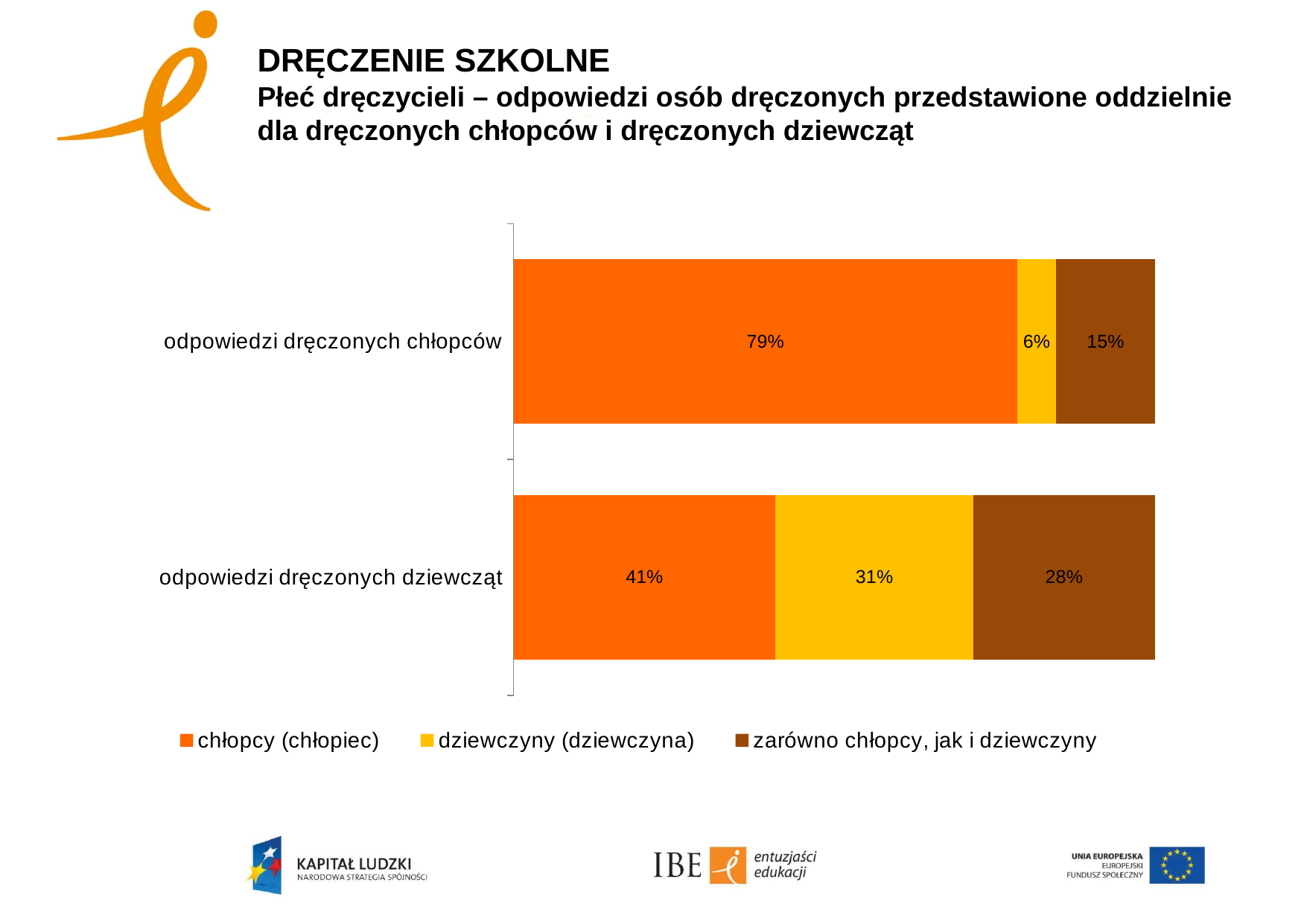
What kind of chart is shown on the slide? Stacked horizontal bar chart What is the value for 'chłopcy (chłopiec)' in the bar for odpowiedzi dręczonych dziewcząt? 41% What is the difference between the 'zarówno chłopcy, jak i dziewczyny' values for odpowiedzi dręczonych dziewcząt and odpowiedzi dręczonych chłopców? 13 percentage points Which series has the largest value in the bar for odpowiedzi dręczonych dziewcząt? chłopcy (chłopiec) What percentage of bullied girls (odpowiedzi dręczonych dziewcząt) answered that the bullies were girls (dziewczyny)? 31% Which category has the higher value for 'dziewczyny (dziewczyna)': odpowiedzi dręczonych chłopców or odpowiedzi dręczonych dziewcząt? odpowiedzi dręczonych dziewcząt What percentage of bullied boys (odpowiedzi dręczonych chłopców) answered that the bullies were boys (chłopcy)? 79% What is the difference between the 'chłopcy (chłopiec)' values for odpowiedzi dręczonych chłopców and odpowiedzi dręczonych dziewcząt? 38 percentage points How many categories (bars) does the chart show? 2 What is the value for 'zarówno chłopcy, jak i dziewczyny' in the bar for odpowiedzi dręczonych chłopców? 15% How many series does the legend list? 3 Which series has the smallest value in the bar for odpowiedzi dręczonych chłopców? dziewczyny (dziewczyna)